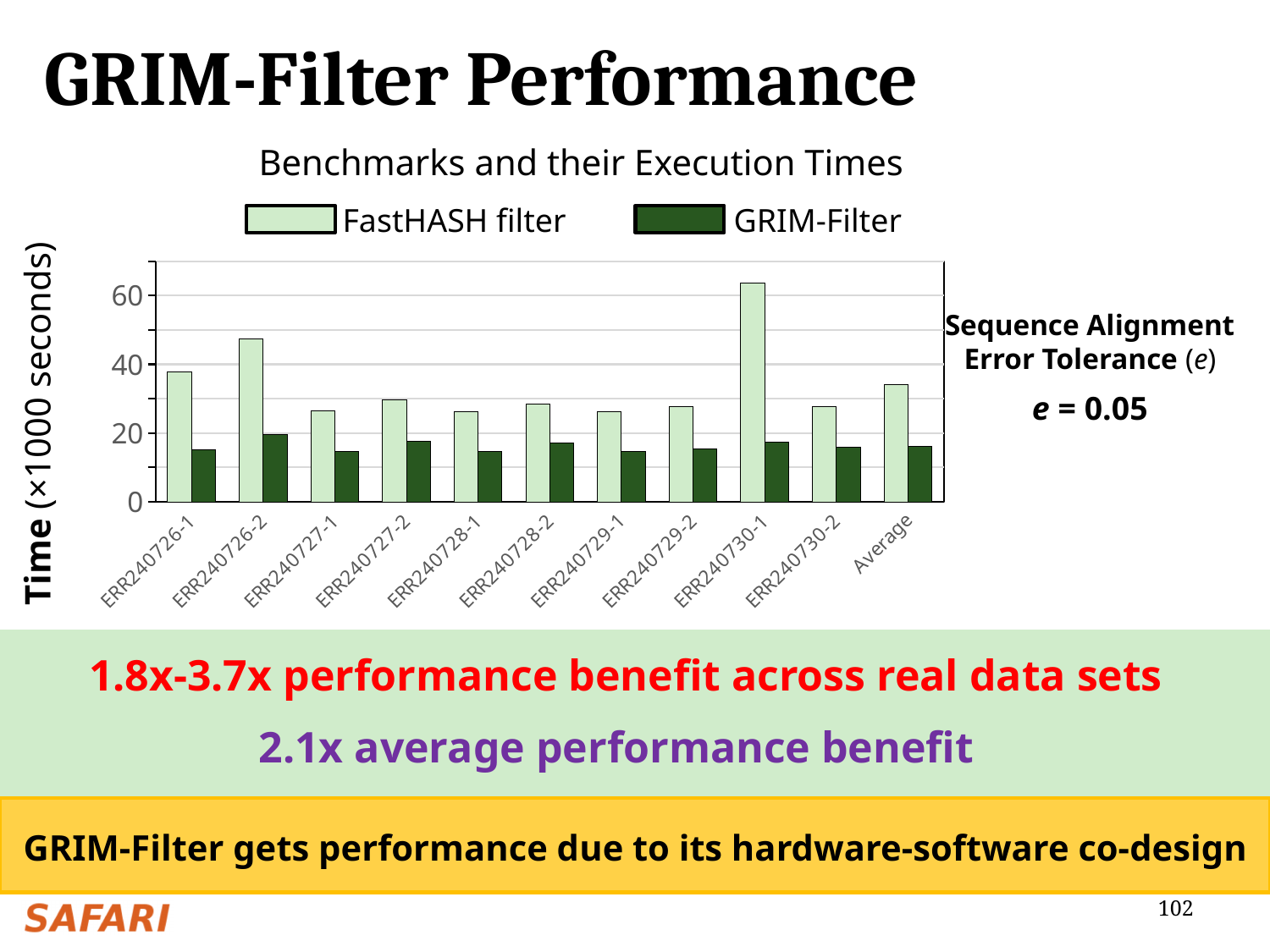
Is the GRIM-Filter value for ERR240726-1 greater or less than 20? less Is the FastHASH filter value for ERR240726-2 greater or less than 40? greater For which benchmark is the GRIM-Filter execution time the highest? ERR240726-2 Which two series are listed in the chart's legend? FastHASH filter and GRIM-Filter Is the FastHASH filter value for ERR240727-1 greater or less than 20? greater What kind of chart is shown on the slide? bar chart How many series does the chart's legend list? 2 For the Average category, which series has the larger execution time, FastHASH filter or GRIM-Filter? FastHASH filter For which benchmark is the FastHASH filter execution time the highest? ERR240730-1 How many categories are shown along the x axis of the chart? 11 What is the title of the chart? Benchmarks and their Execution Times